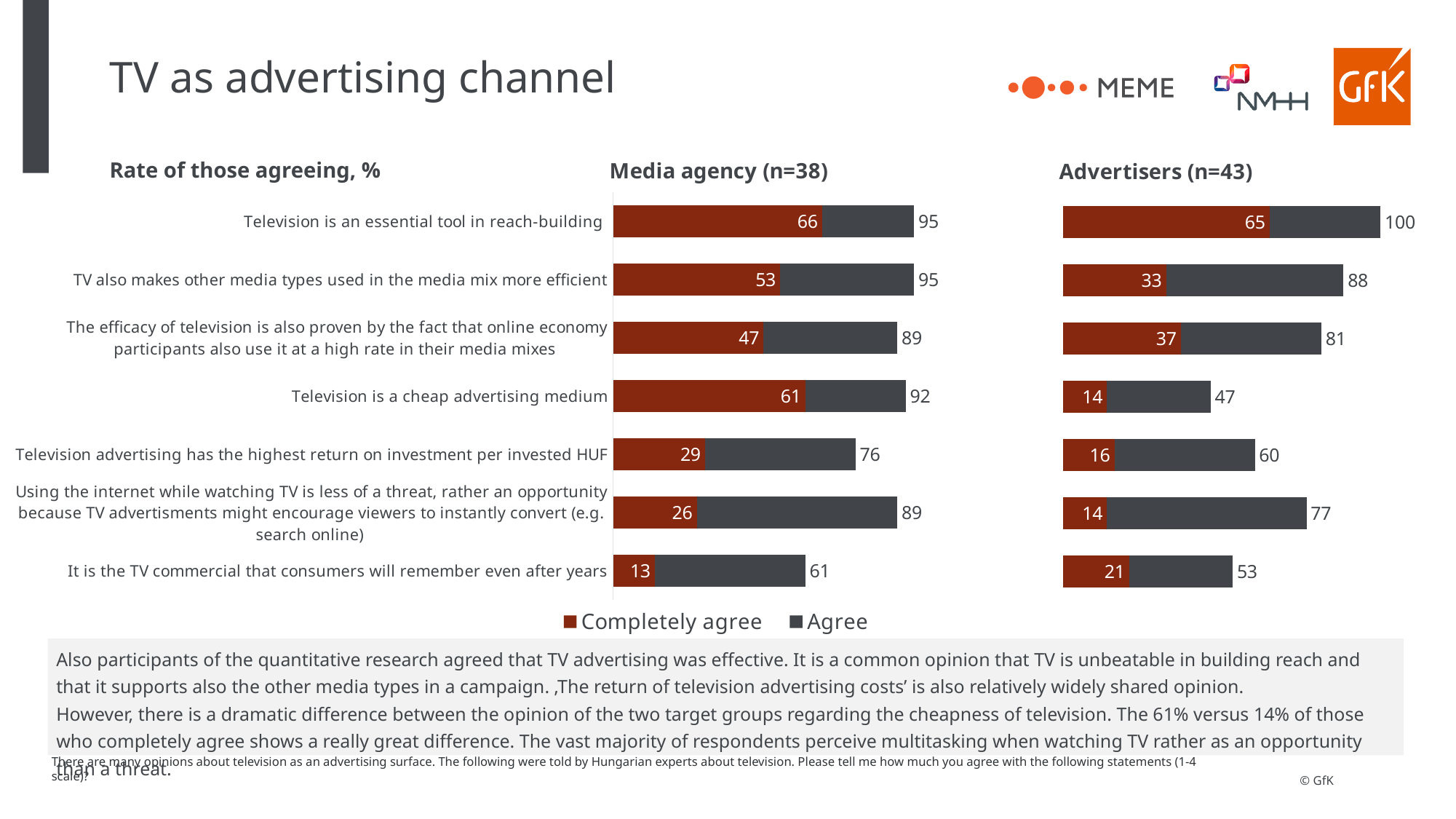
In the Advertisers (n=43) chart, which statement has the lowest total rate of those agreeing? Television is a cheap advertising medium In the Advertisers (n=43) chart, what percentage completely agree that television is a cheap advertising medium? 14 How many statements are plotted in each chart? 7 What type of chart is used on this slide? Stacked bar chart In the Media agency (n=38) chart, what percentage completely agree that television is an essential tool in reach-building? 66 How many series does the legend list? 2 Which chart shows a higher total rate of agreement for 'TV also makes other media types used in the media mix more efficient', Media agency or Advertisers? Media agency What is the difference between the 'Completely agree' values for 'Television is a cheap advertising medium' in the Media agency chart and the Advertisers chart? 47 In the Media agency (n=38) chart, what is the 'Agree' (not completely) share for 'Television advertising has the highest return on investment per invested HUF', given the total of 76 and completely agree of 29? 47 In the Media agency (n=38) chart, which statement has the highest 'Completely agree' value? Television is an essential tool in reach-building In the Media agency (n=38) chart, which statement has the lowest total rate of those agreeing? It is the TV commercial that consumers will remember even after years In the Advertisers (n=43) chart, what is the total rate of those agreeing that television is an essential tool in reach-building? 100